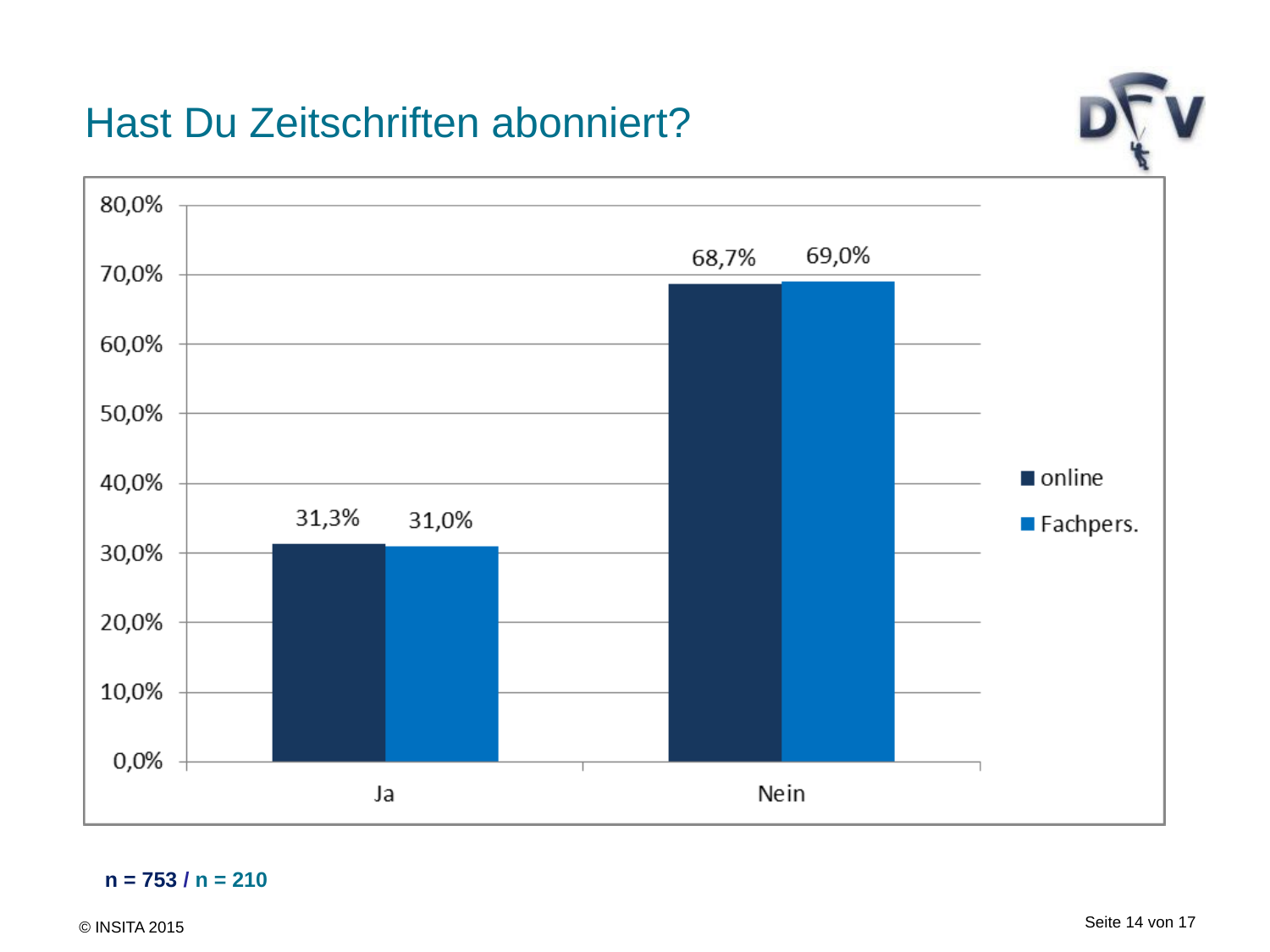
Which is larger: the "online" value for "Nein" or the "online" value for "Ja"? Nein What is the title of the slide? Hast Du Zeitschriften abonniert? What is the value for "Fachpers." in the "Ja" category? 31,0% How many categories are shown on the x axis? 2 What kind of chart is shown on the slide? bar chart What is the difference between the "online" values for "Nein" and "Ja"? 37,4% What is the value for "online" in the "Ja" category? 31,3% What is the value for "Fachpers." in the "Nein" category? 69,0% What is the value for "online" in the "Nein" category? 68,7% Which category has the lowest value for the "Fachpers." series? Ja How many series does the legend list? 2 Which category has the highest value for the "online" series? Nein